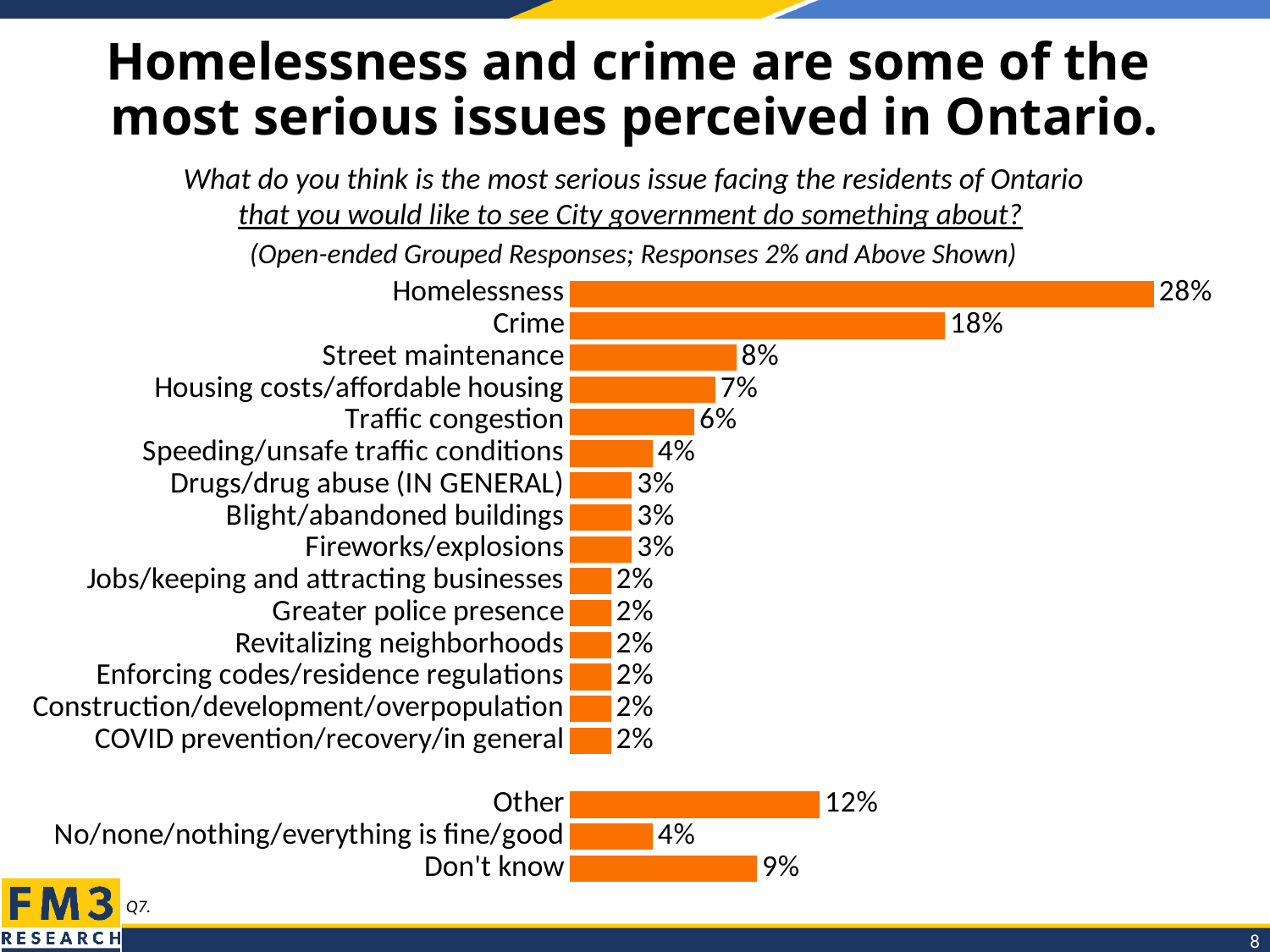
What colour are the bars in the chart? Orange Which issue has the highest percentage? Homelessness What percentage of respondents named Homelessness as the most serious issue? 28% What is the difference between the values for Homelessness and Crime? 10 percentage points What percentage is shown for Street maintenance? 8% How many categories on the chart are shown with a value of 2%? 6 What is the value shown for Crime? 18% What type of chart is shown on the slide? Bar chart What is the difference between the values for Other and Don't know? 3 percentage points Which is larger, the value for Traffic congestion or the value for Housing costs/affordable housing? Housing costs/affordable housing What is the value for Don't know? 9% What percentage is shown for Other? 12%